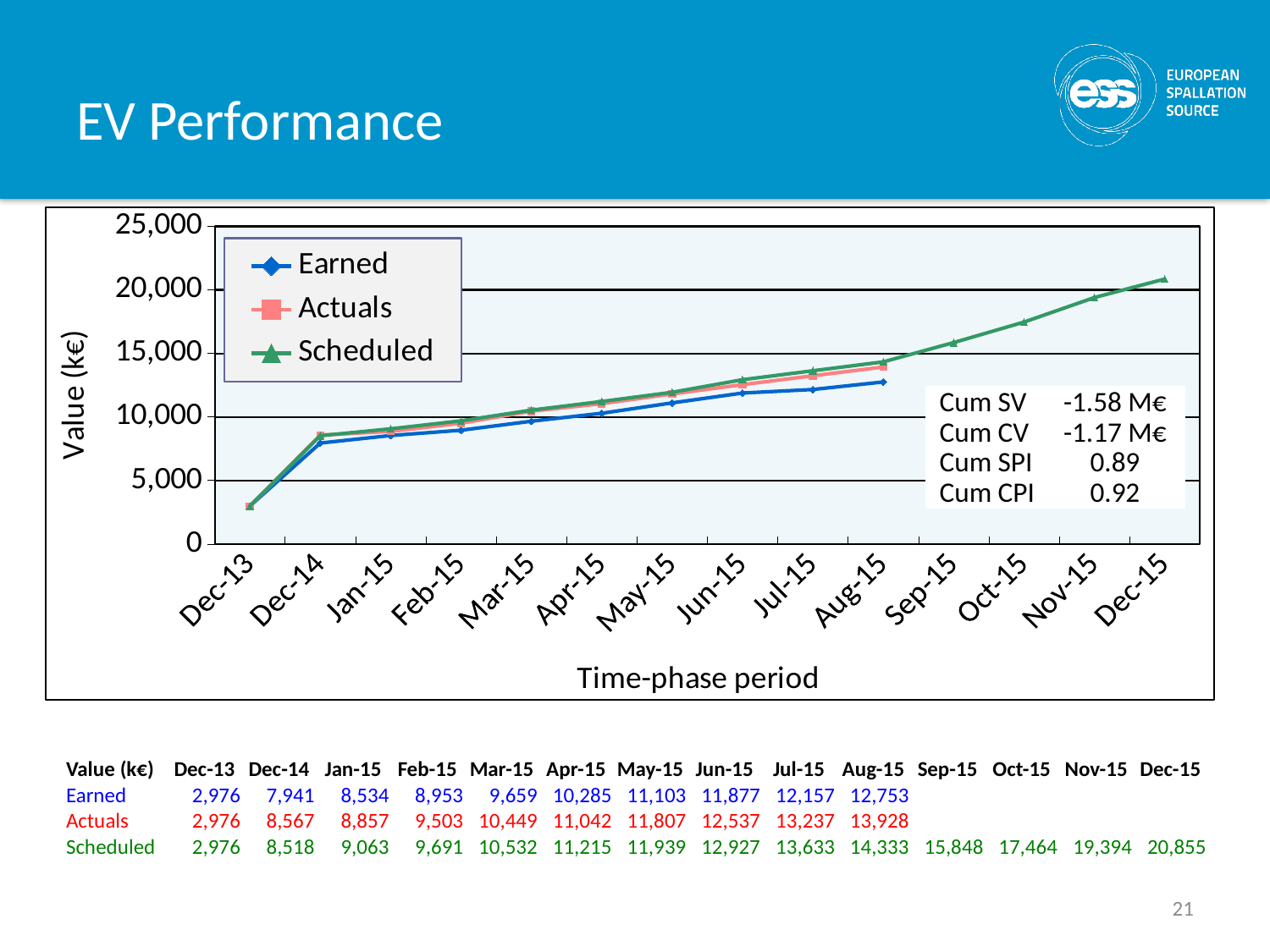
In which period does the Scheduled series reach its highest value? Dec-15 Which is larger in Jul-15, the Actuals value or the Earned value? Actuals What is the Scheduled value for Dec-15? 20,855 How many time-phase periods are shown on the x axis? 14 What is the difference between the Actuals and Earned values for Aug-15? 1,175 What is the Actuals value for Mar-15? 10,449 Is the Scheduled value for Dec-15 greater or less than 20,000? greater What is the difference between the Scheduled and Earned values for Aug-15? 1,580 Do the Scheduled values rise or fall from Dec-13 to Dec-15? rise What kind of chart is shown on the slide? line chart What is the Earned value for Aug-15? 12,753 How many series does the legend list? 3